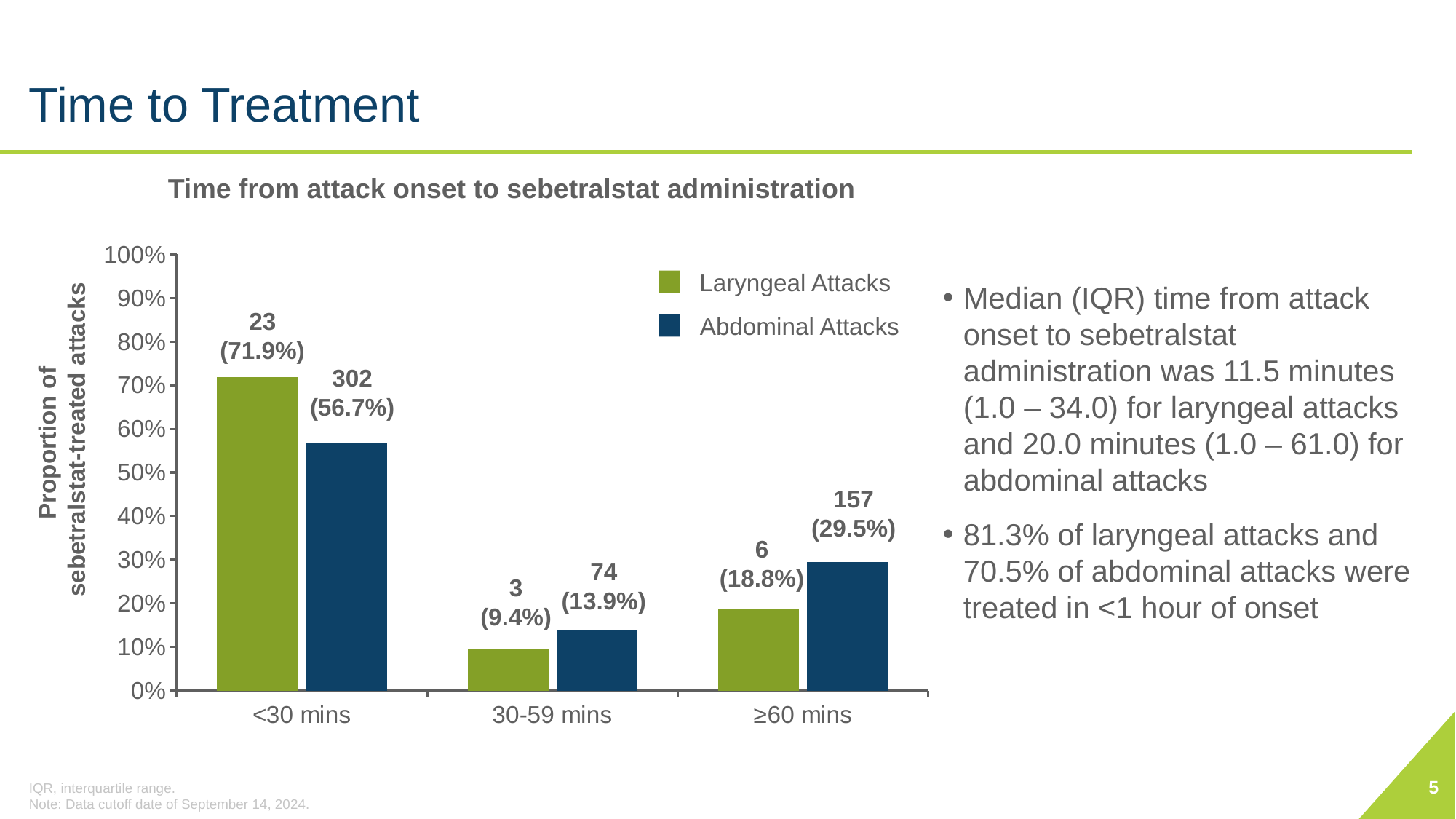
What percentage of laryngeal attacks were treated in <30 mins? 71.9% What is the difference in percentage points between laryngeal and abdominal attacks in the <30 mins category? 15.2 percentage points What percentage of abdominal attacks were treated in ≥60 mins? 29.5% In the ≥60 mins category, which series has the larger proportion, Laryngeal Attacks or Abdominal Attacks? Abdominal Attacks Which time category has the highest proportion of laryngeal attacks? <30 mins Is the proportion of abdominal attacks treated in <30 mins greater or less than 50%? greater How many series does the legend list? 2 Which time category has the lowest proportion of abdominal attacks? 30-59 mins What type of chart is shown on the slide? Bar chart How many abdominal attacks were treated in 30-59 mins? 74 How many time categories are shown on the x axis? 3 What is the title of the chart? Time from attack onset to sebetralstat administration